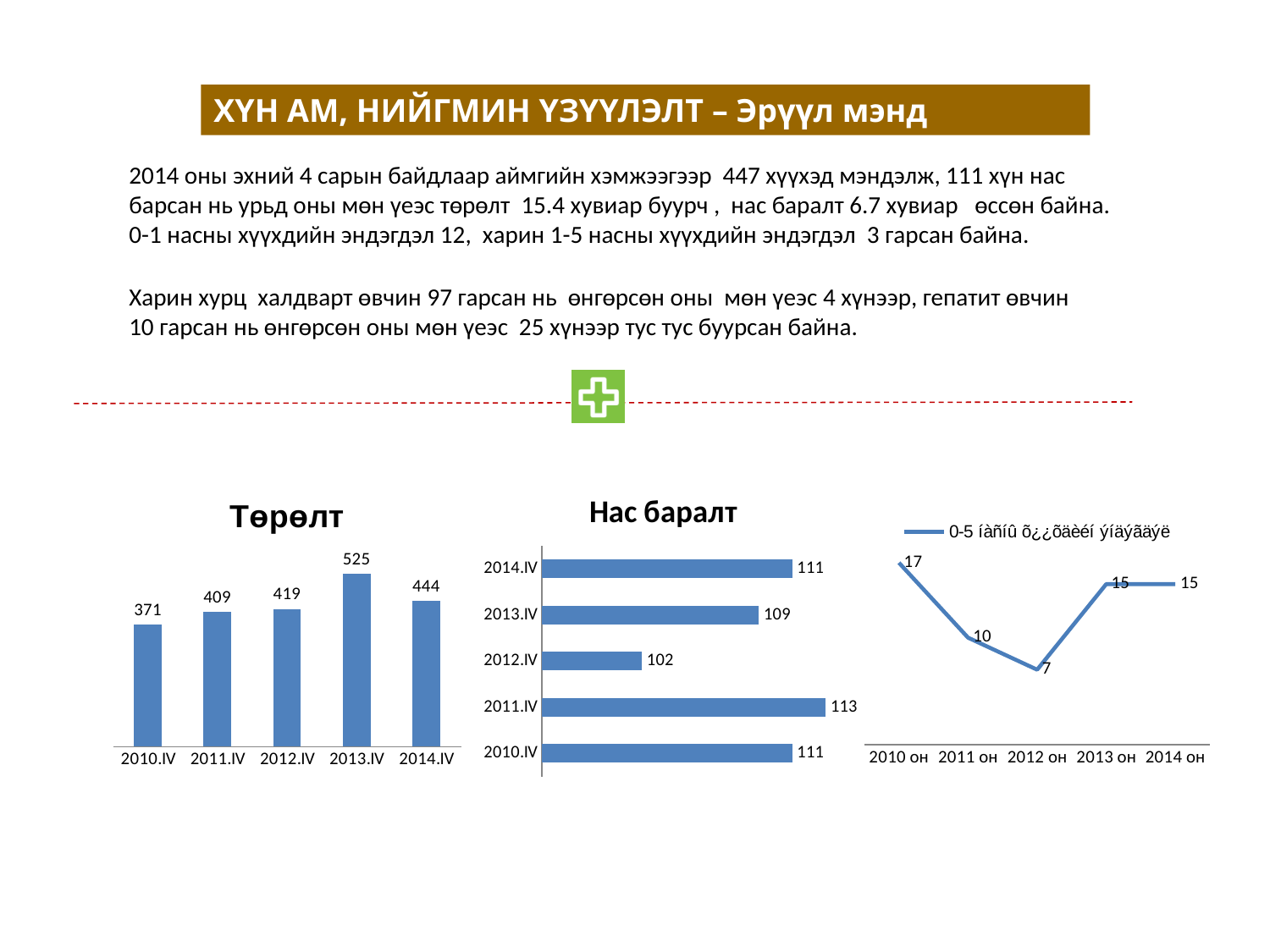
What kind of chart is the "Нас баралт" chart? bar chart In the "Нас баралт" chart, which category has the highest value? 2011.IV In the "Төрөлт" chart, what is the difference between the values for 2013.IV and 2014.IV? 81 In the "Нас баралт" chart, what is the value for 2012.IV? 102 In the line chart on the right of the slide, do the values rise or fall from 2010 он to 2012 он? fall In the "Нас баралт" chart, what is the difference between the values for 2011.IV and 2012.IV? 11 In the "Төрөлт" chart, which category has the lowest value? 2010.IV In the "Нас баралт" chart, is the value for 2013.IV larger or smaller than the value for 2011.IV? smaller In the "Төрөлт" chart, what is the value for 2013.IV? 525 In the line chart on the right of the slide, which year has the highest value? 2010 он In the line chart on the right of the slide, what is the value for 2012 он? 7 In the "Төрөлт" chart, how many bars are plotted? 5